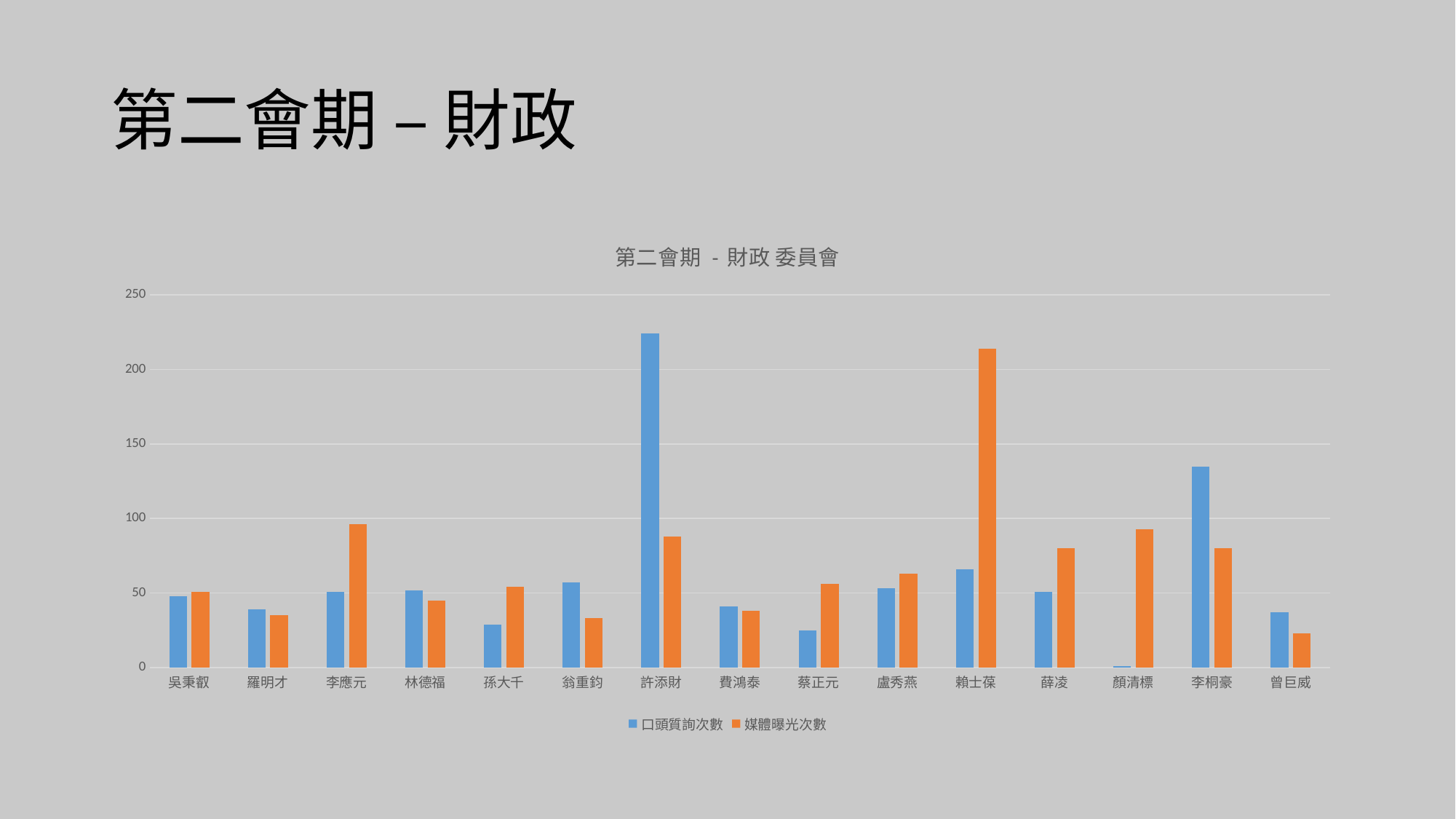
Which category has the lowest 口頭質詢次數? 顏清標 For 賴士葆, which is larger: 口頭質詢次數 or 媒體曝光次數? 媒體曝光次數 What kind of chart is shown on the slide? bar chart Is the 口頭質詢次數 value for 許添財 greater or less than 200? greater Which category has the highest 媒體曝光次數? 賴士葆 Is the 口頭質詢次數 value for 李桐豪 greater or less than 100? greater How many series does the legend list? 2 Which category has the highest 口頭質詢次數? 許添財 What is the title of the chart? 第二會期 - 財政 委員會 How many categories (people) are shown on the x axis? 15 Is the 口頭質詢次數 value for 蔡正元 greater or less than 50? less Which category has the lowest 媒體曝光次數? 曾巨威